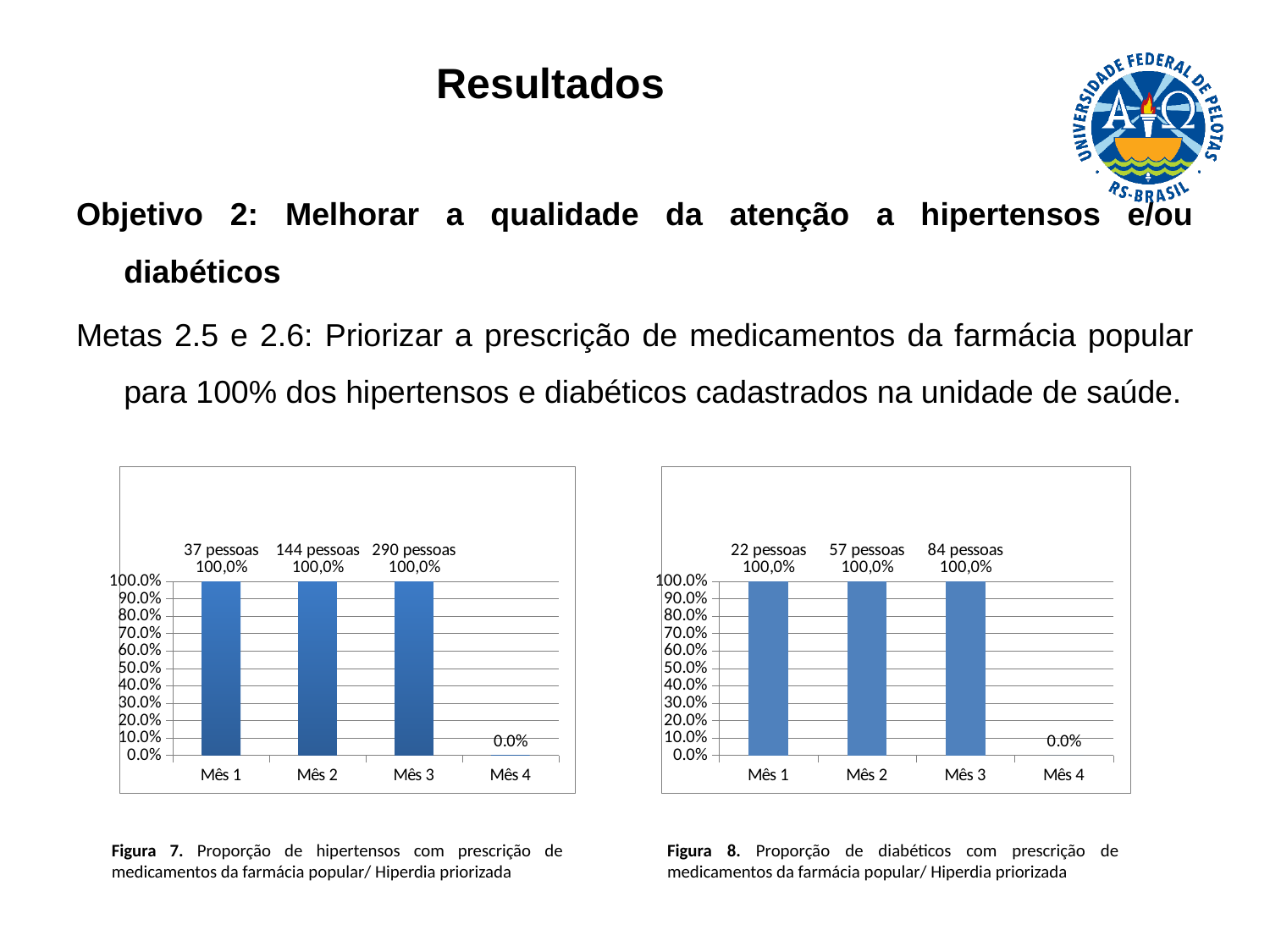
In the right chart (Figura 8), which month has the lowest value? Mês 4 In the right chart (Figura 8), how many people does the label for Mês 2 report? 57 pessoas In the right chart (Figura 8), how many people does the label for Mês 1 report? 22 pessoas In the left chart (Figura 7), what is the difference between the values for Mês 1 and Mês 4? 100,0% In the right chart (Figura 8), is the value for Mês 2 larger or smaller than the value for Mês 4? larger In the left chart (Figura 7), which month has the lowest value? Mês 4 In the left chart (Figura 7), how many people does the label for Mês 3 report? 290 pessoas In the left chart (Figura 7), what is the value for Mês 4? 0.0% How many months (categories) are shown on the x axis of the right chart (Figura 8)? 4 In the left chart (Figura 7), what is the value for Mês 2? 100,0% What kind of chart is the left chart (Figura 7)? bar chart In the right chart (Figura 8), what is the value for Mês 3? 100,0%